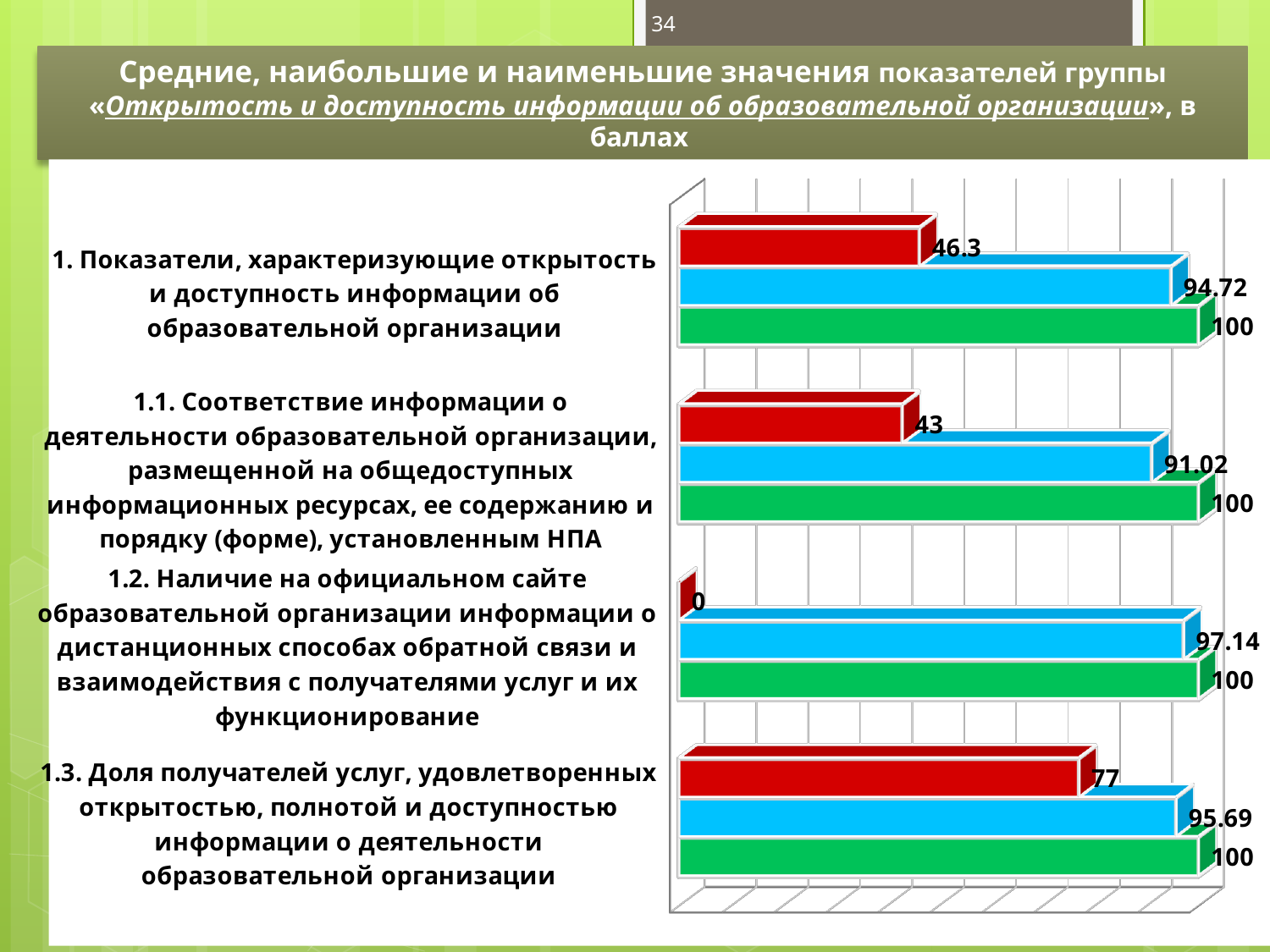
What is the value of the red bar for category 1.3 (Доля получателей услуг, удовлетворенных открытостью, полнотой и доступностью информации)? 77 Which category has the lowest blue bar value? 1.1. Соответствие информации о деятельности образовательной организации, размещенной на общедоступных информационных ресурсах, ее содержанию и порядку (форме), установленным НПА What is the value of the red bar for category 1.2 (Наличие на официальном сайте информации о дистанционных способах обратной связи)? 0 What is the difference between the green bar and the red bar for category 1.1? 57 How many categories are plotted in the chart? 4 What is the value of the green bar for category 1.3? 100 What is the value of the blue bar for category 1.1 (Соответствие информации о деятельности образовательной организации...)? 91.02 What kind of chart is shown on the slide? bar chart Which is larger: the blue bar for category 1.2 or the blue bar for category 1.3? category 1.2 (97.14) What is the difference between the blue bar values of category 1 and category 1.1? 3.7 Which category has the highest red bar value? 1.3. Доля получателей услуг, удовлетворенных открытостью, полнотой и доступностью информации о деятельности образовательной организации What is the value of the blue bar for category 1 (Показатели, характеризующие открытость и доступность информации)? 94.72